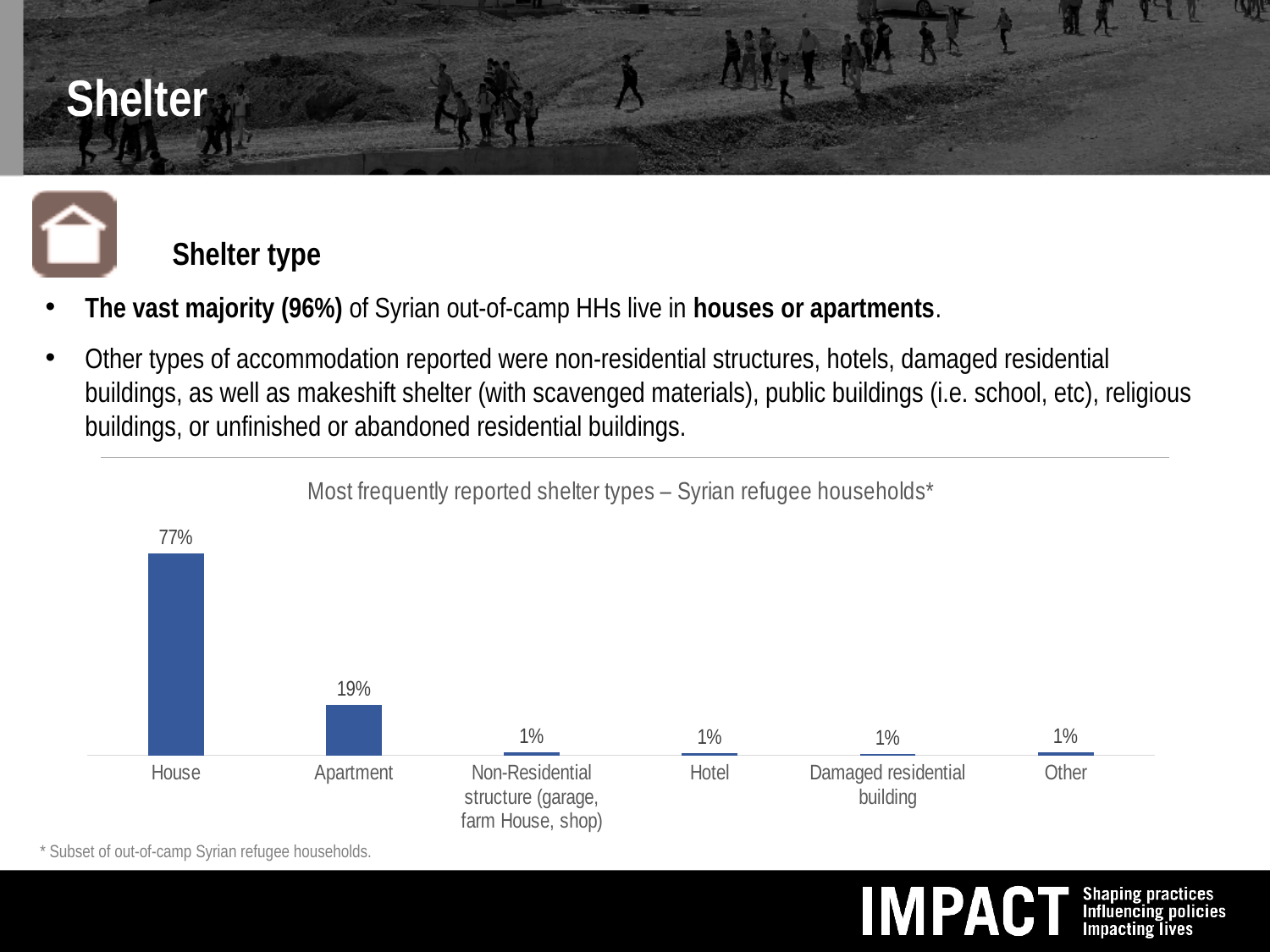
Do the values rise or fall moving from left to right across the categories? Fall How many shelter type categories are shown on the chart? 6 What kind of chart is used to show the shelter types? Bar chart What is the title of the chart? Most frequently reported shelter types – Syrian refugee households* What value is shown for 'Damaged residential building'? 1% Which shelter type has the highest reported percentage? House Which is larger, the value for Apartment or the value for Hotel? Apartment What is the difference in percentage points between House and Apartment? 58 What percentage of Syrian refugee households reported living in an apartment? 19% What percentage of Syrian refugee households reported living in a house? 77% What percentage of households reported living in a hotel? 1% What is the combined percentage for House and Apartment? 96%